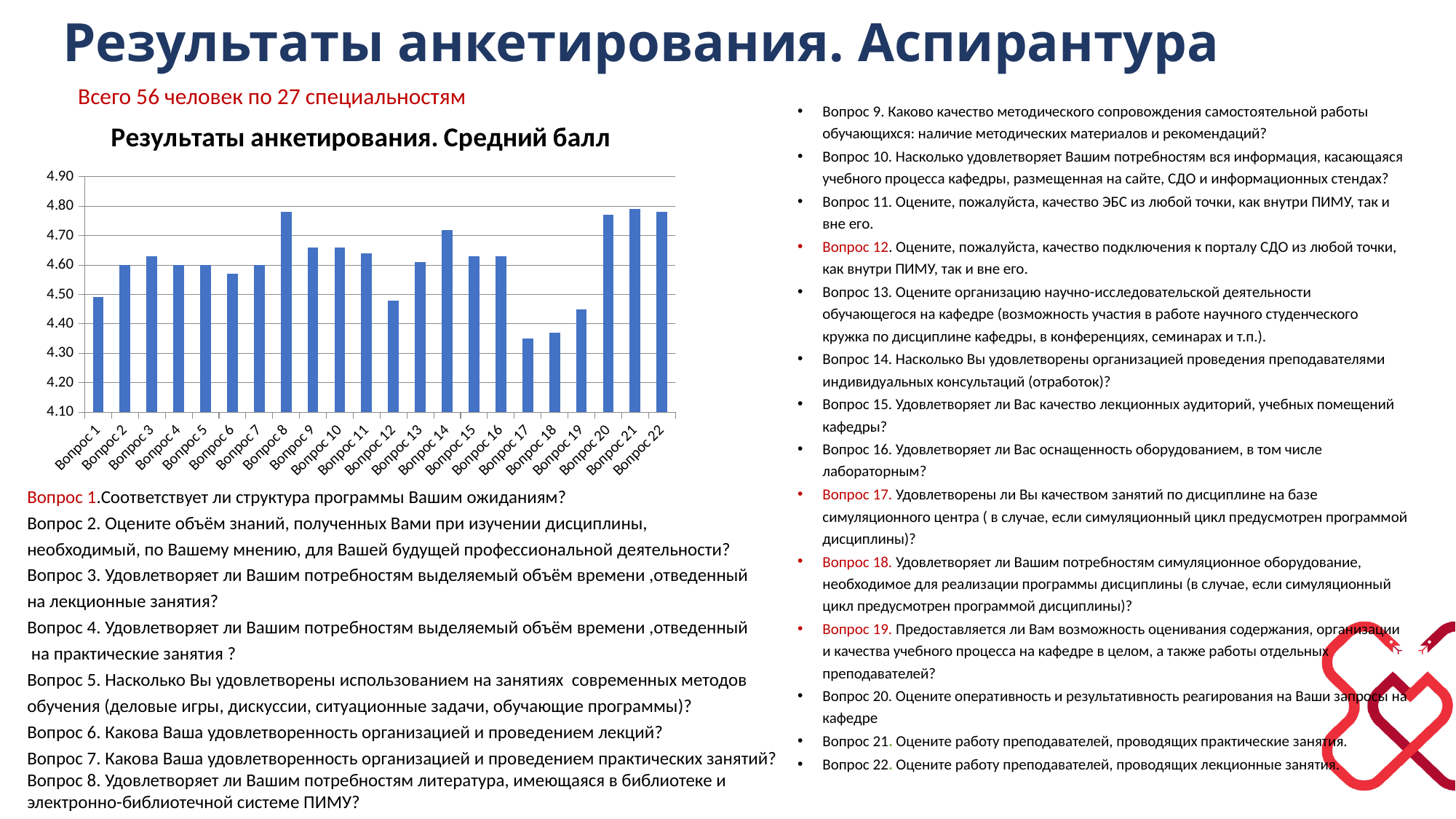
Which has the larger value, Вопрос 14 or Вопрос 19? Вопрос 14 Is the value for Вопрос 19 greater or less than 4.50? less Is the value for Вопрос 20 greater or less than 4.70? greater Is the value for Вопрос 8 greater or less than 4.70? greater How many categories (questions) are plotted on the chart? 22 What kind of chart is shown on the slide? bar chart What is the title of the chart? Результаты анкетирования. Средний балл Which has the larger value, Вопрос 8 or Вопрос 17? Вопрос 8